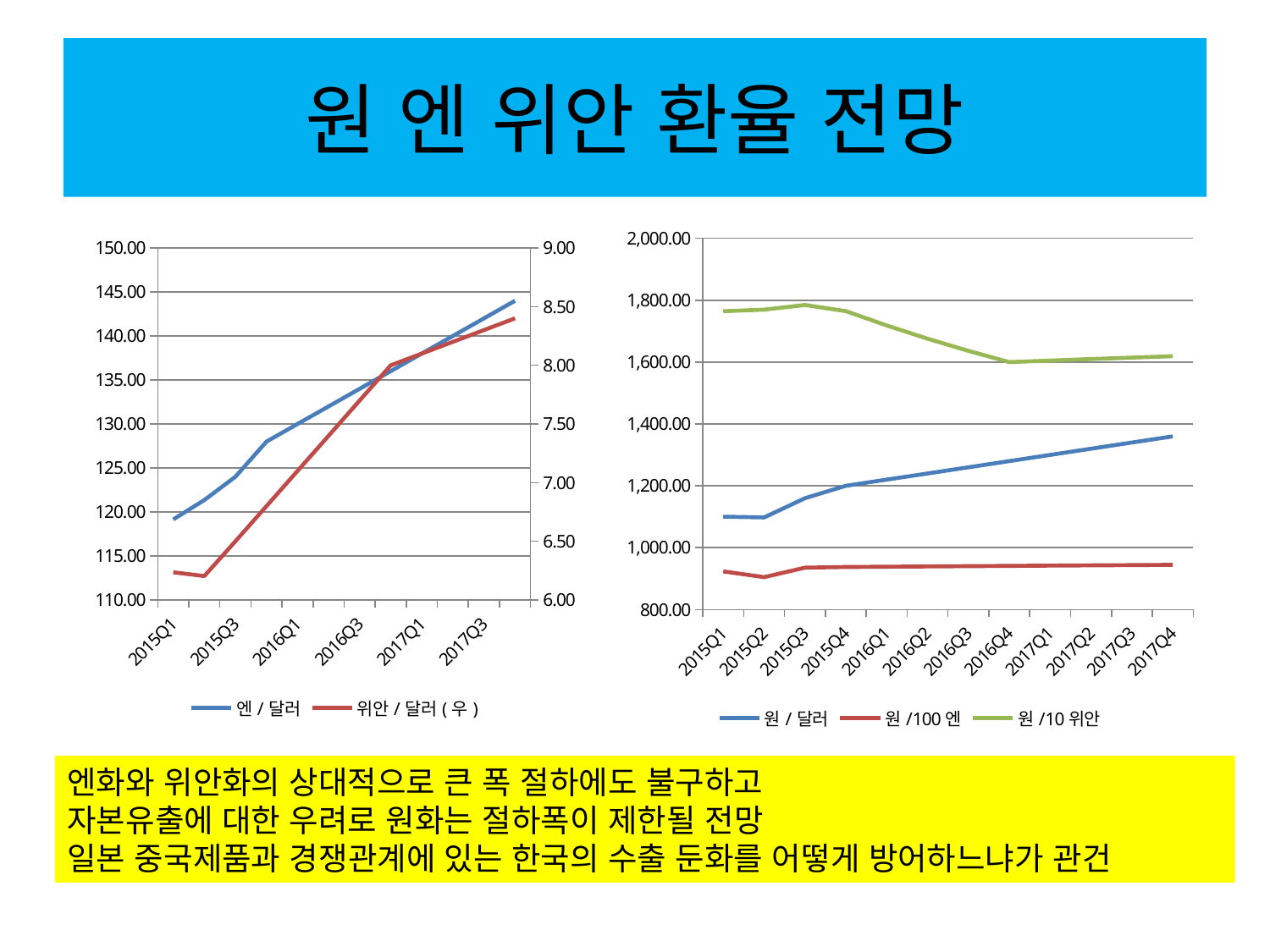
How many series does the legend of the left chart list? 2 How many series does the legend of the right chart list? 3 What kind of chart is the left chart on the slide? line chart In the right chart, is the 원 / 달러 value at 2015Q1 greater or less than 1,200.00? less In the right chart, is the 원 /10 위안 value at 2015Q3 greater or less than 1,600.00? greater In the right chart, does the 원 /10 위안 line rise or fall overall from 2015Q1 to 2017Q4? fall In the left chart, does the 엔 / 달러 line rise or fall from 2015Q1 to 2017Q4? rise In the right chart, which series has the highest values across all quarters? 원 /10 위안 In the left chart, is the 위안 / 달러 ( 우 ) value at 2015Q1 greater or less than 6.50? less In the right chart, at 2017Q4, which is larger: 원 / 달러 or 원 /100 엔? 원 / 달러 How many quarters are labelled on the x axis of the right chart? 12